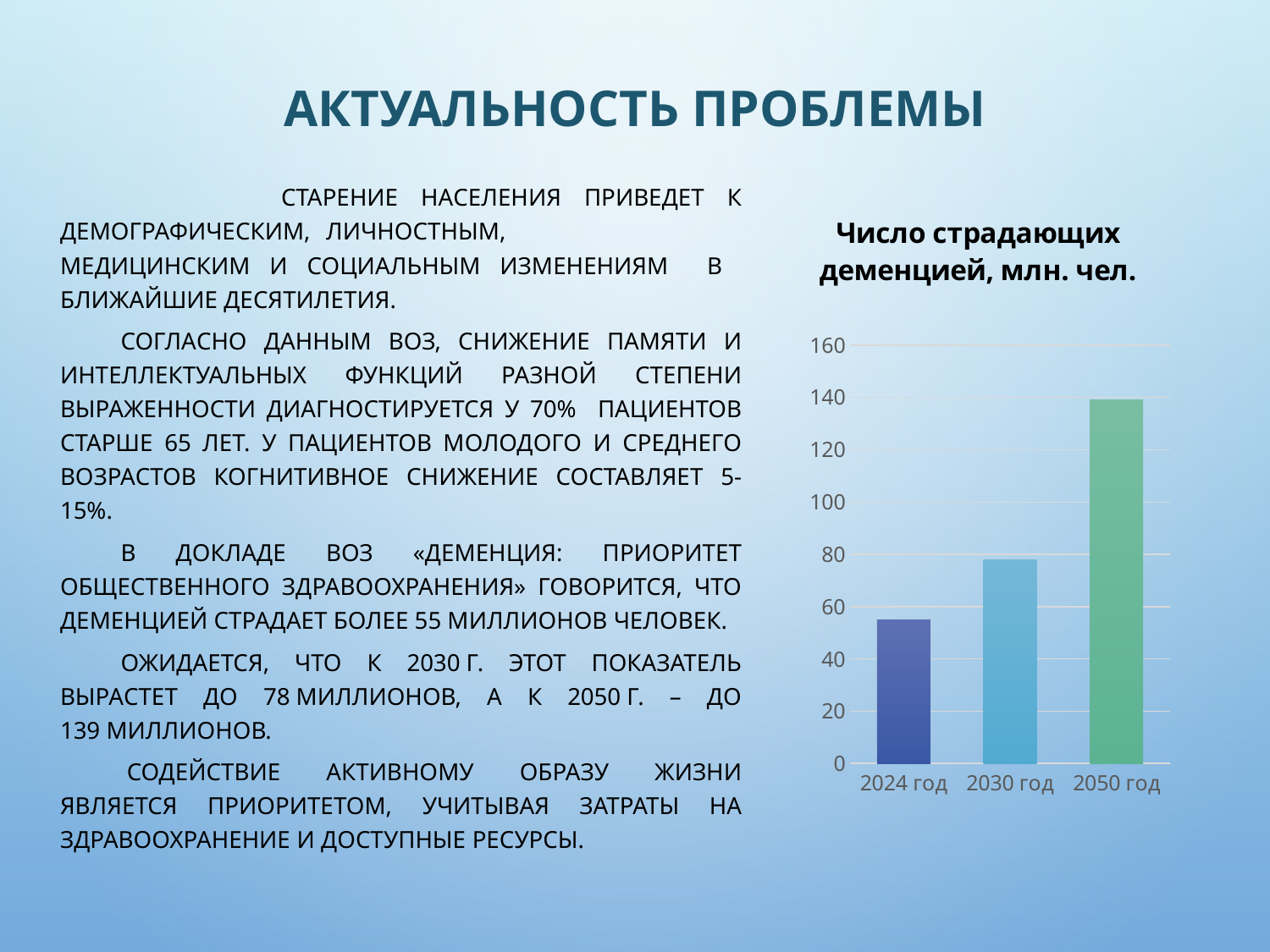
Is the value for 2030 год greater or less than 60? greater Is the value for 2024 год greater or less than 60? less What is the title of the chart? Число страдающих деменцией, млн. чел. Is the value for 2024 год greater or less than 40? greater What is the highest value shown on the vertical axis of the chart? 160 How many categories are plotted on the chart? 3 Which category has the lowest value on the chart? 2024 год Do the values rise or fall from 2024 год to 2050 год? rise Which is larger, the value for 2030 год or the value for 2024 год? 2030 год What kind of chart is shown on the slide? bar chart Which category has the highest value on the chart? 2050 год